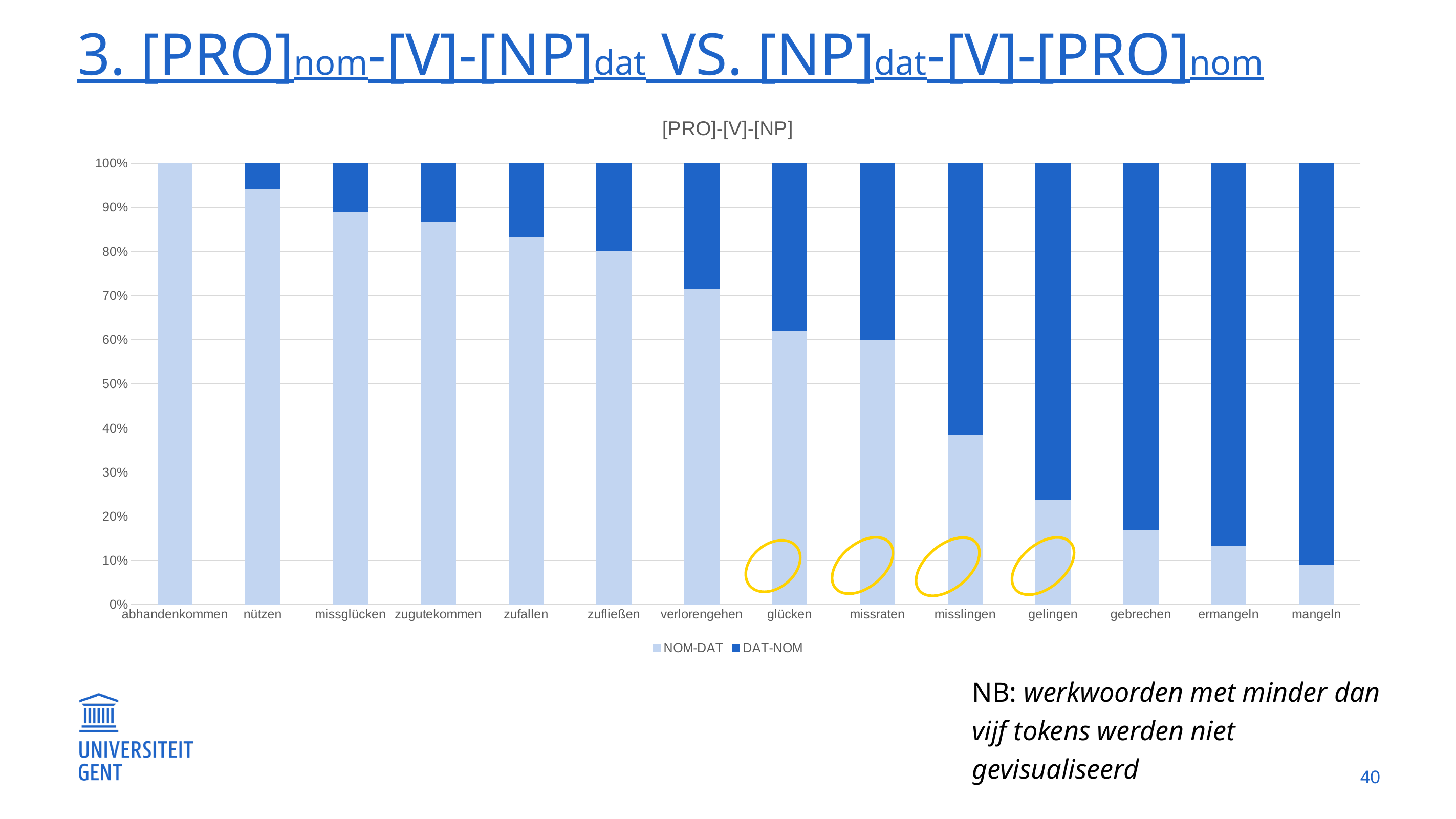
Is the NOM-DAT share for nützen greater or less than 90%? greater What kind of chart is shown on the slide? bar chart Which verb has the lowest NOM-DAT share? mangeln What is the title shown above the chart? [PRO]-[V]-[NP] Is the NOM-DAT share for misslingen greater or less than 40%? less How many verbs (categories) are shown on the x axis of the chart? 14 Which verb has the highest NOM-DAT share? abhandenkommen Is the NOM-DAT share for mangeln greater or less than 10%? less What is the NOM-DAT share for abhandenkommen? 100% What are the two series named in the legend? NOM-DAT and DAT-NOM Which verb has the larger NOM-DAT share, glücken or gelingen? glücken How many series does the chart legend list? 2